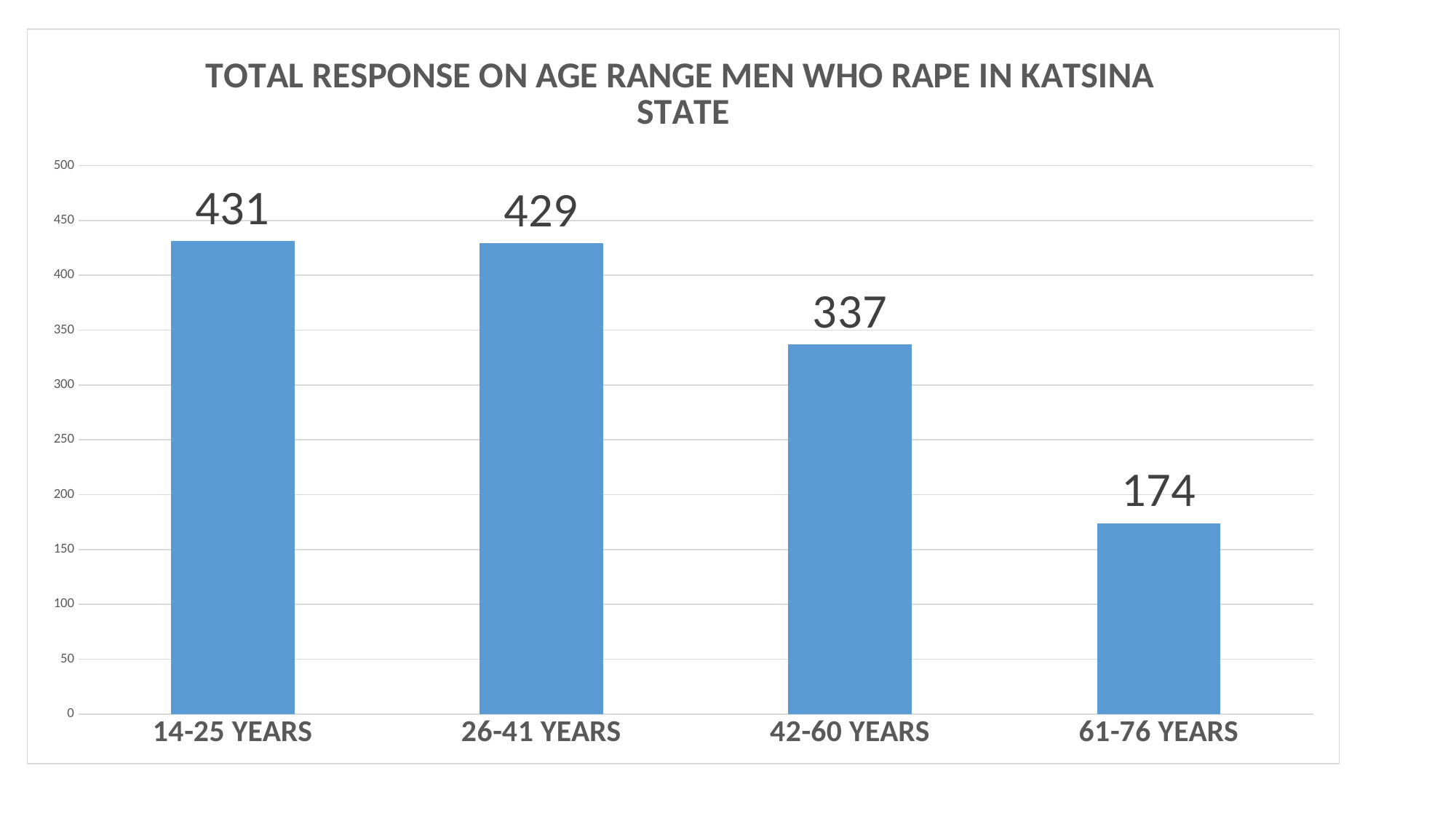
How many age range categories are shown on the chart? 4 What is the difference between the values for 14-25 YEARS and 42-60 YEARS? 94 Which age range has the lowest value? 61-76 YEARS What is the value for 42-60 YEARS? 337 Which age range has the highest value? 14-25 YEARS What is the value for 26-41 YEARS? 429 Do the values rise or fall from left to right across the age ranges? Fall What kind of chart is shown on the slide? Bar chart What is the difference between the values for 42-60 YEARS and 61-76 YEARS? 163 What is the value for 14-25 YEARS? 431 Which is larger, the value for 26-41 YEARS or the value for 42-60 YEARS? 26-41 YEARS What is the value for 61-76 YEARS? 174